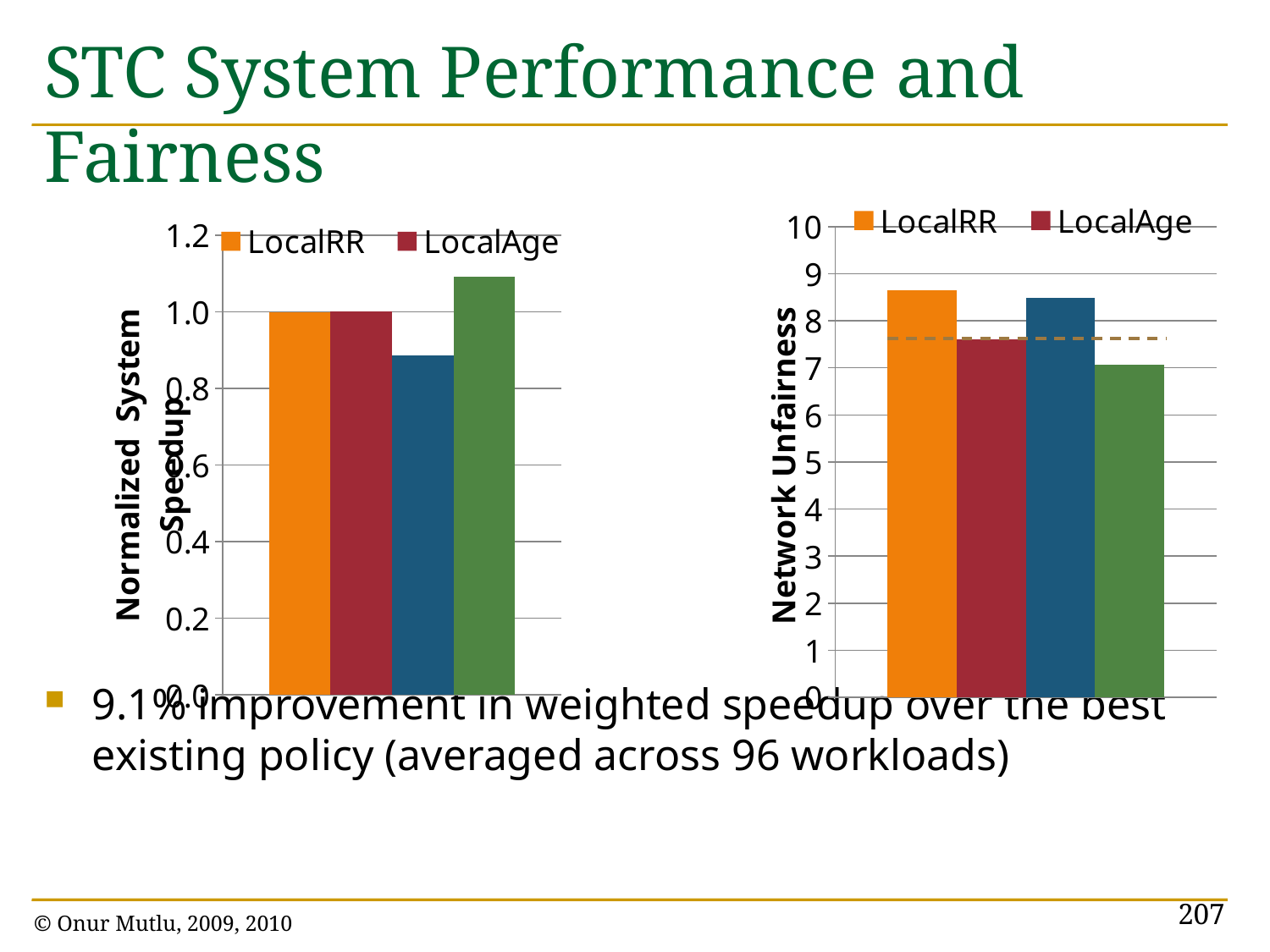
In the right chart (Network Unfairness), is the value for LocalRR greater or less than 9? less How many series does the legend of the right chart (Network Unfairness) list? 2 In the right chart (Network Unfairness), is the value for LocalRR greater or less than 8? greater In the right chart (Network Unfairness), is the value for LocalAge greater or less than 8? less How many bars are plotted in the left chart (Normalized System Speedup)? 4 What is the y-axis title of the left chart? Normalized System Speedup How many bars are plotted in the right chart (Network Unfairness)? 4 What is the y-axis title of the right chart? Network Unfairness In the left chart (Normalized System Speedup), what is the value for LocalRR? 1.0 In the right chart (Network Unfairness), which is larger, LocalRR or LocalAge? LocalRR What kind of chart is the left chart (Normalized System Speedup)? bar chart